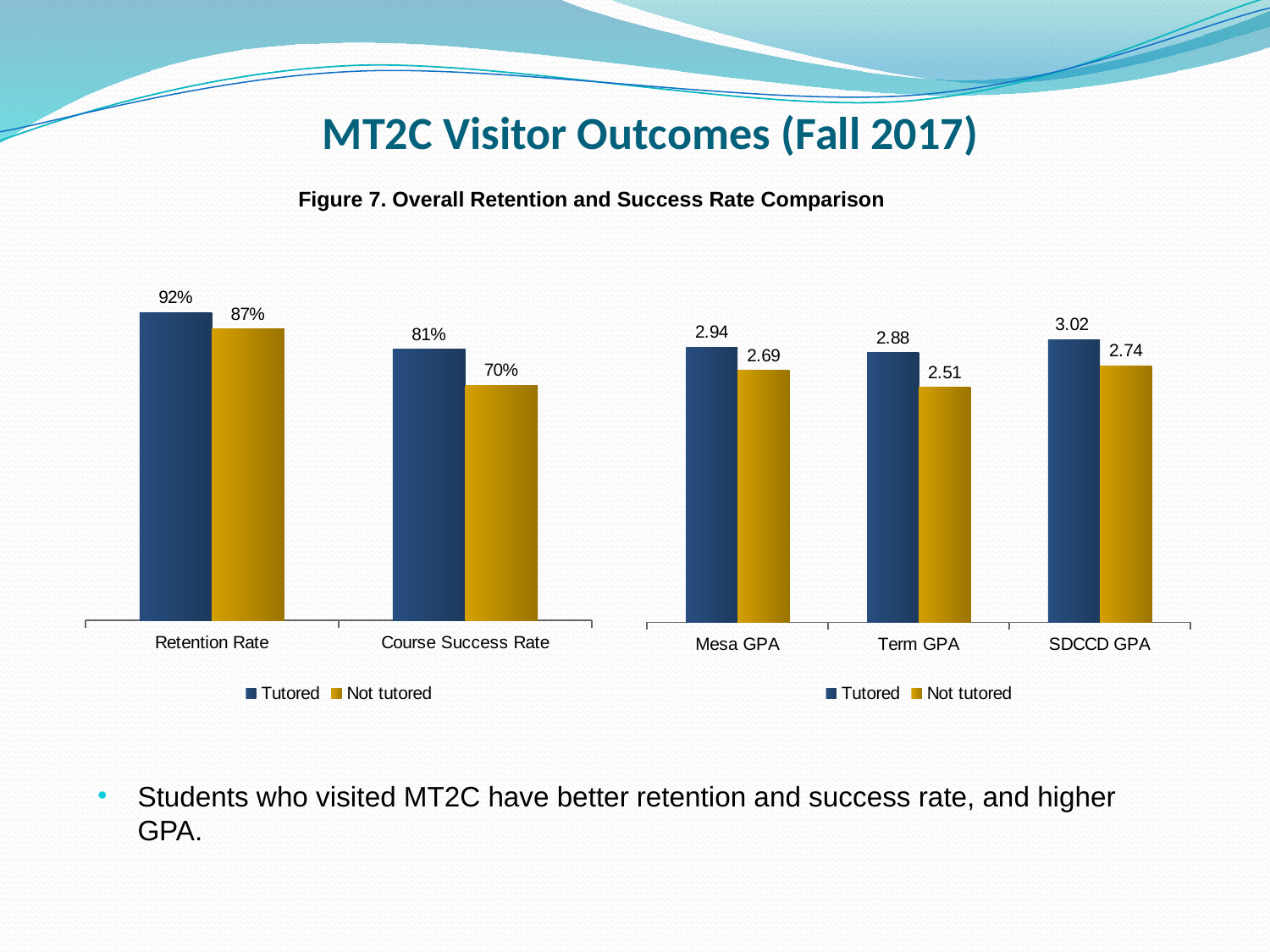
In the left chart (Retention Rate and Course Success Rate), which is larger for Retention Rate: Tutored or Not tutored? Tutored In the right chart (GPA comparison), what is the difference between the Tutored and Not tutored values for Term GPA? 0.37 In the right chart (GPA comparison), which category has the lowest Not tutored value? Term GPA What type of chart is the right chart (GPA comparison)? Bar chart In the right chart (GPA comparison), what is the Not tutored value for Term GPA? 2.51 In the left chart (Retention Rate and Course Success Rate), what is the Tutored value for Retention Rate? 92% In the left chart (Retention Rate and Course Success Rate), how many series does the legend list? 2 In the right chart (GPA comparison), how many categories are shown on the x axis? 3 In the right chart (GPA comparison), which category has the highest Tutored value? SDCCD GPA In the right chart (GPA comparison), what is the Tutored value for SDCCD GPA? 3.02 In the left chart (Retention Rate and Course Success Rate), what is the difference between the Tutored and Not tutored values for Course Success Rate? 11% In the left chart (Retention Rate and Course Success Rate), what is the Not tutored value for Course Success Rate? 70%